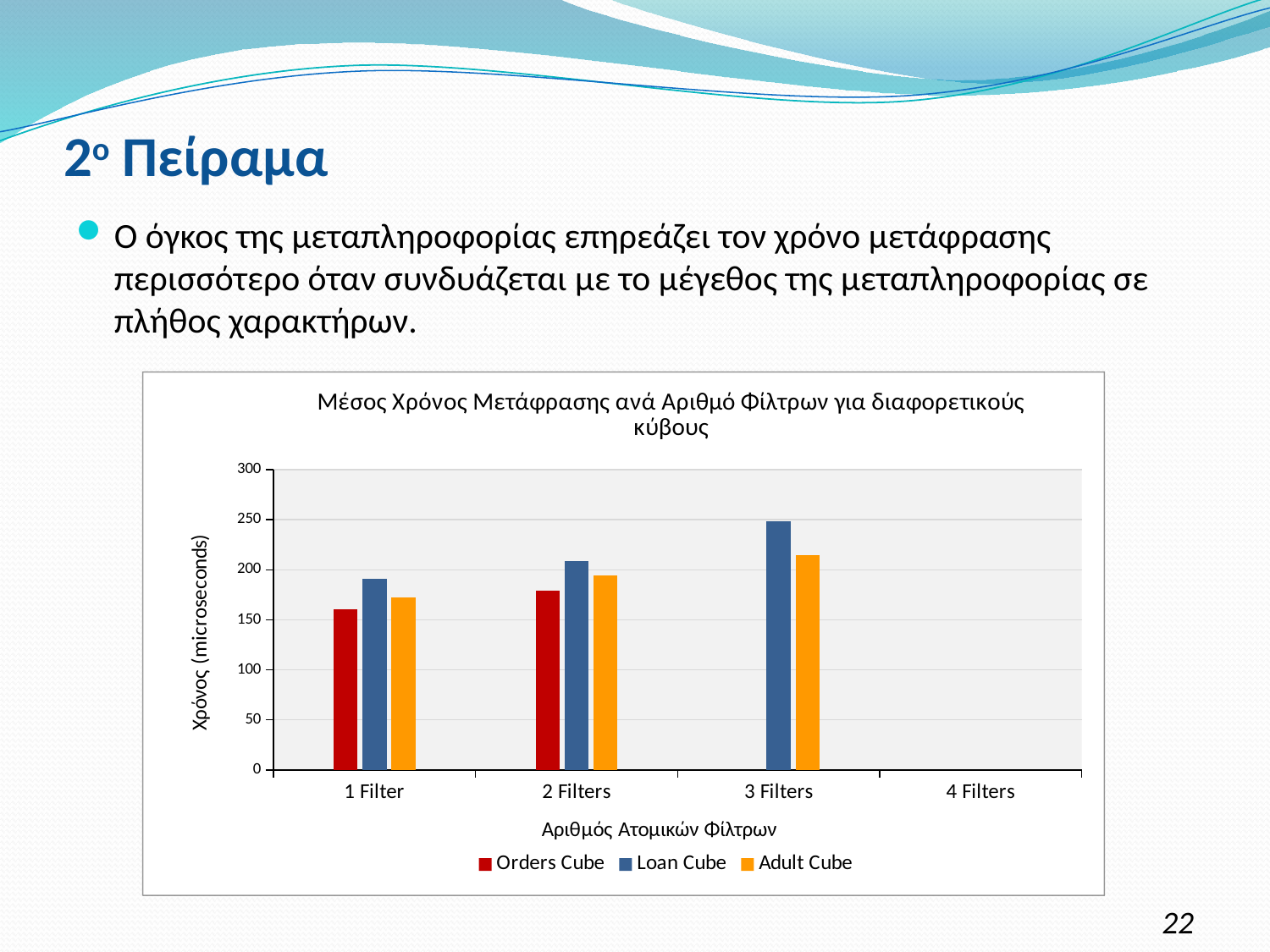
Which colour represents Adult Cube in the legend? orange Which series has the highest value at 3 Filters? Loan Cube At 2 Filters, which is larger: Loan Cube or Orders Cube? Loan Cube Do the Loan Cube values rise or fall from 1 Filter to 3 Filters? rise What is the label of the y axis? Χρόνος (microseconds) How many series does the legend list? 3 What kind of chart is shown on the slide? bar chart Which series has the lowest value at 1 Filter? Orders Cube How many categories are shown on the x axis? 4 Is the value for Orders Cube at 1 Filter greater or less than 200? less Is the value for Loan Cube at 3 Filters greater or less than 200? greater Is the value for Adult Cube at 2 Filters greater or less than 150? greater